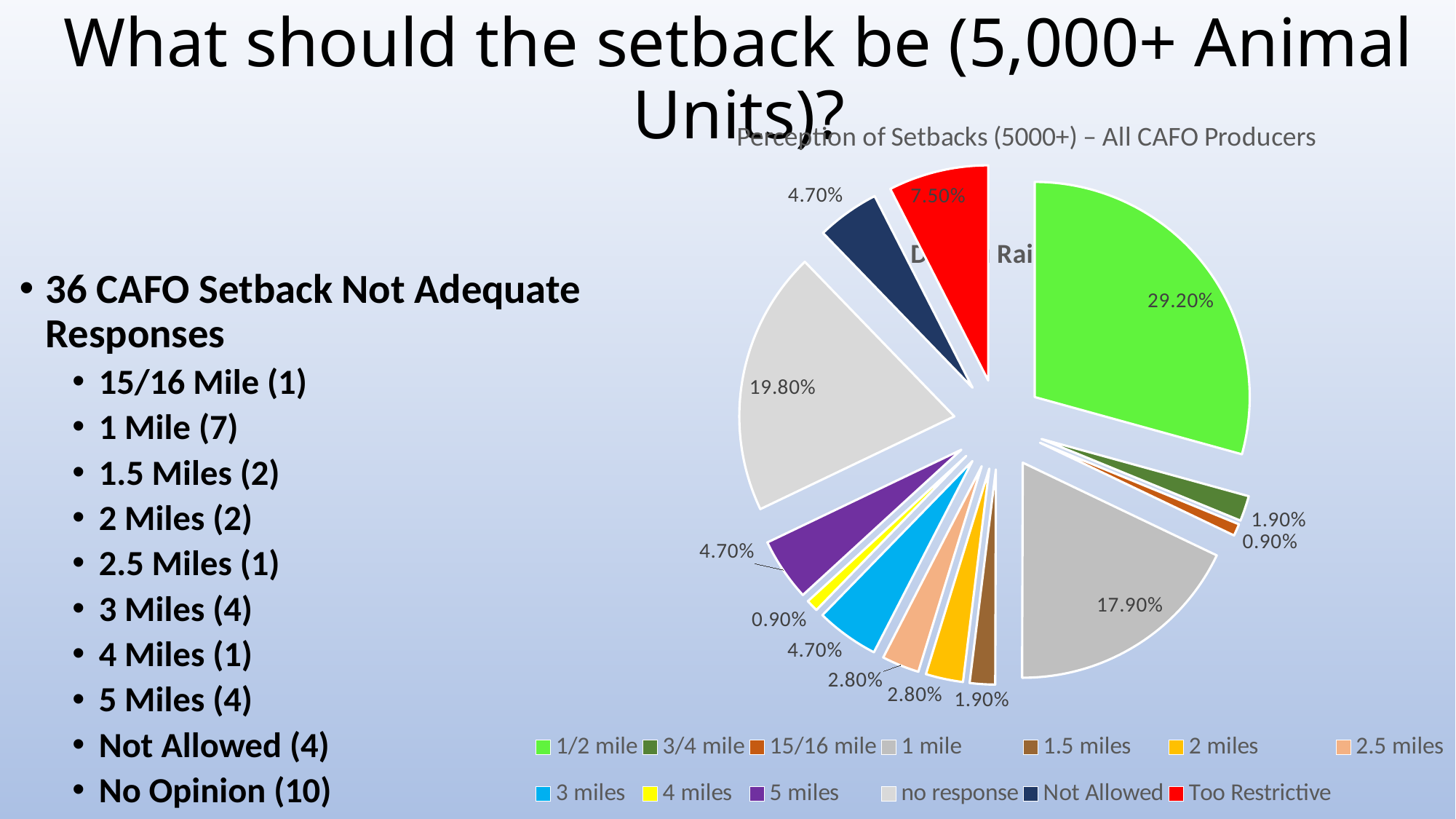
What percentage is shown for the 1 mile slice? 17.90% Which category has the largest slice of the pie? 1/2 mile What percentage is shown for the Not Allowed slice? 4.70% What is the difference in percentage points between the 1/2 mile slice and the 1 mile slice? 11.30% What type of chart is shown on the slide? pie chart Which is larger, the 1 mile slice or the no response slice? no response What percentage is shown for the Too Restrictive slice? 7.50% What percentage is shown for the no response slice? 19.80% What colour is the Too Restrictive slice? red What is the title of the chart? Perception of Setbacks (5000+) – All CAFO Producers How many categories does the chart's legend list? 13 What percentage of the pie is the 1/2 mile slice? 29.20%